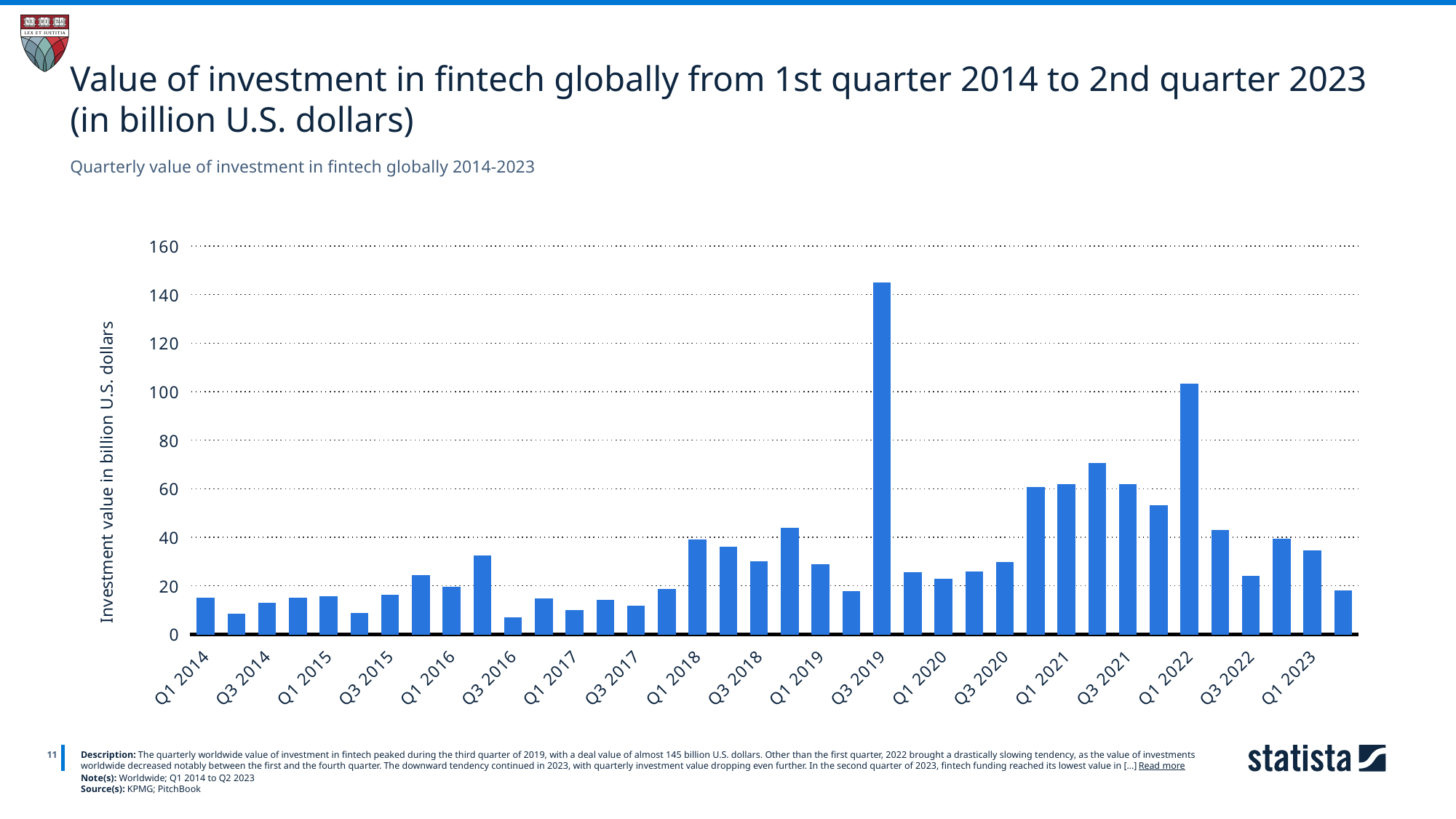
Is the value for Q1 2021 greater or less than 40? greater Which is larger, the value for Q3 2019 or the value for Q1 2022? Q3 2019 Is the value for Q1 2023 greater or less than 20? greater Is the value for Q1 2022 greater or less than 80? greater Do the values rise or fall from Q1 2020 to Q1 2021? rise How many quarterly bars are plotted in the chart? 38 Which is larger, the value for Q1 2020 or the value for Q1 2021? Q1 2021 What kind of chart is shown on the slide? bar chart What is the label of the vertical axis? Investment value in billion U.S. dollars Which quarter has the highest value of fintech investment? Q3 2019